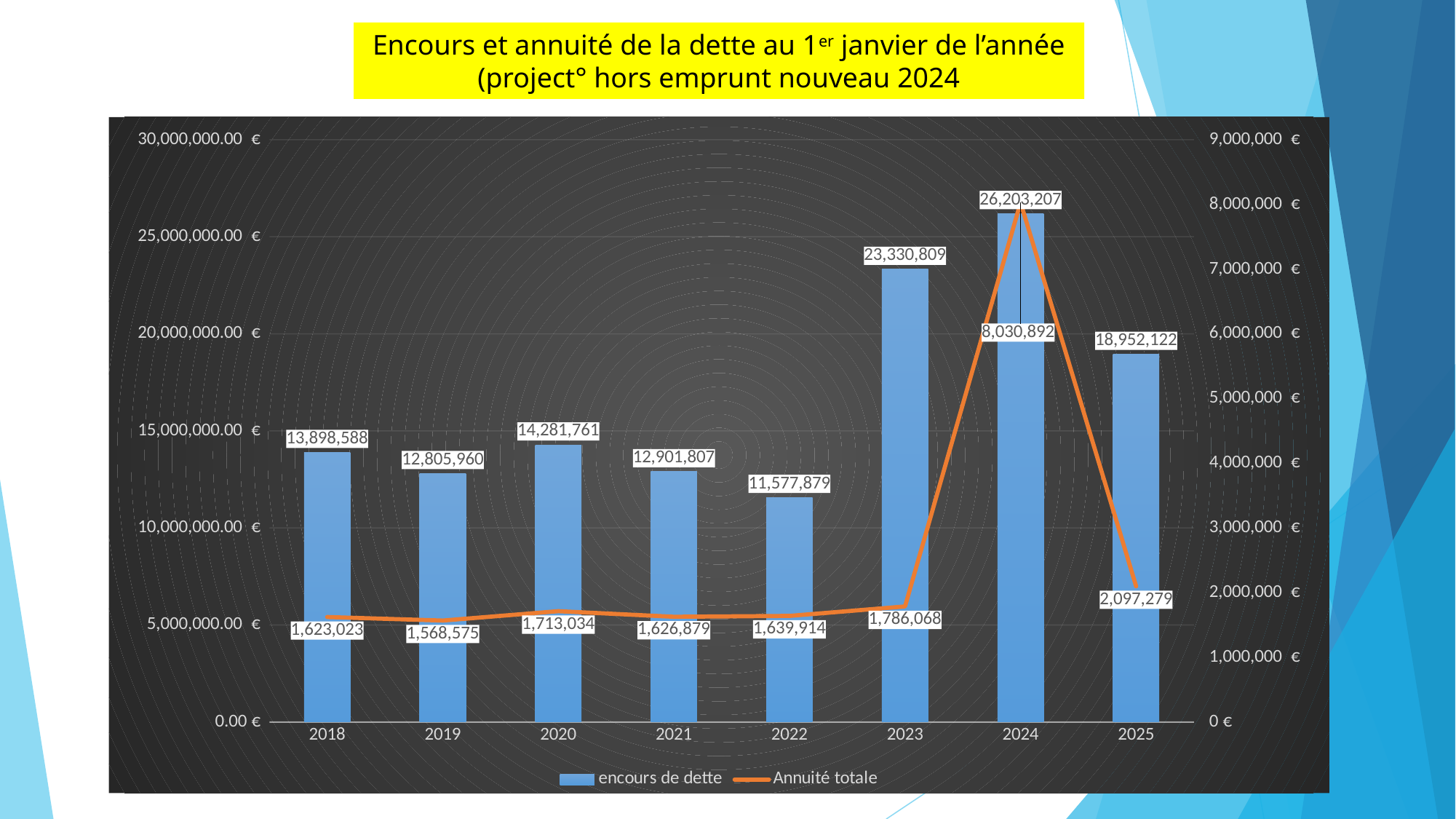
How many years are shown on the x axis? 8 How many series does the legend list? 2 What is the value of encours de dette for 2022? 11,577,879 What is the Annuité totale for 2019? 1,568,575 Which series is drawn as a line rather than bars? Annuité totale What is the value of encours de dette for 2023? 23,330,809 Which year has the highest encours de dette? 2024 Which year has the lowest Annuité totale? 2019 What is the Annuité totale for 2024? 8,030,892 What is the difference between the encours de dette in 2024 and in 2025? 7,251,085 Which is larger, the encours de dette in 2020 or in 2021? 2020 Which year has the lowest encours de dette? 2022